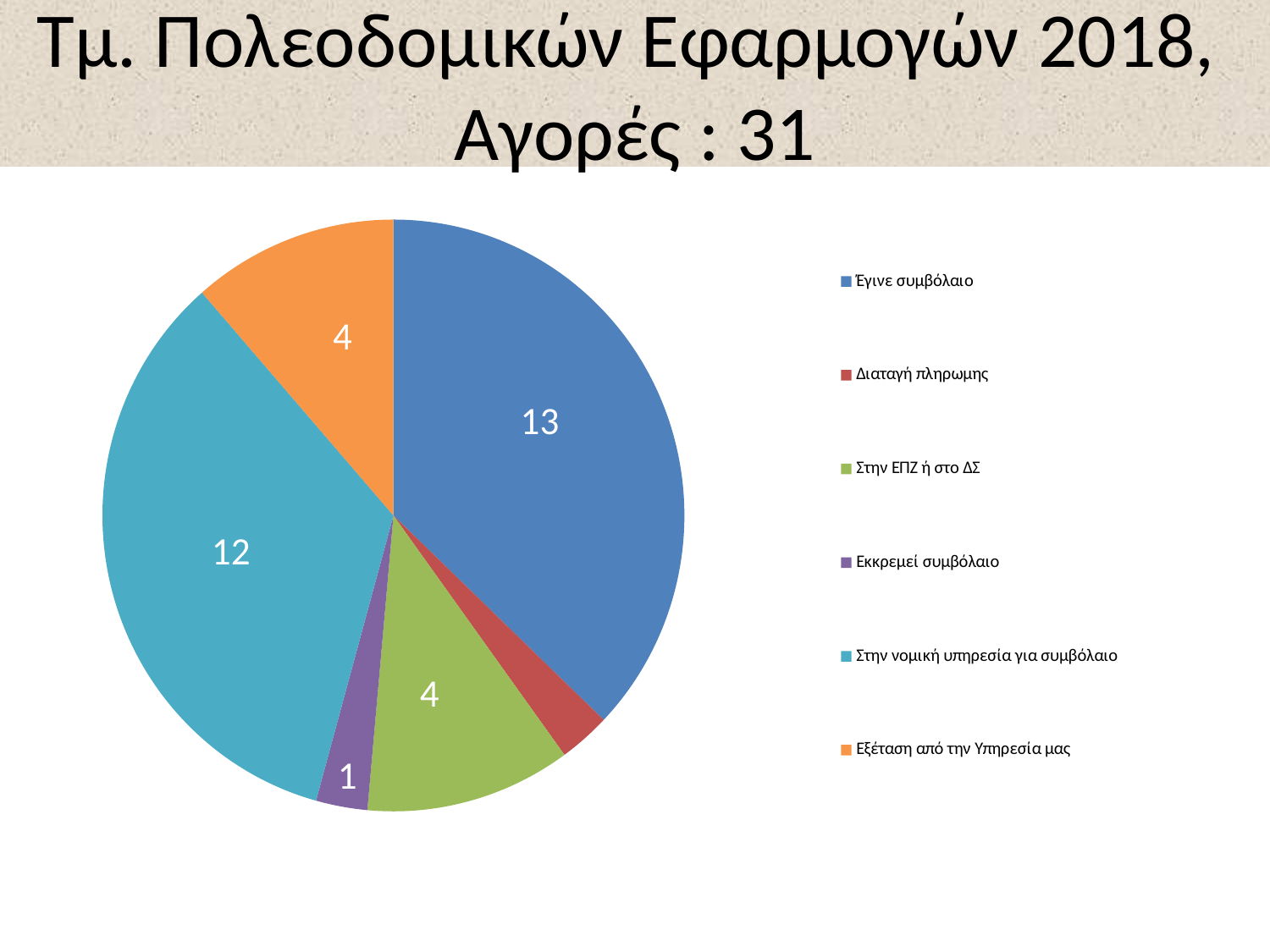
What is the value for Εξέταση από την Υπηρεσία μας? 4 Which category has the largest slice of the pie? Έγινε συμβόλαιο What is the value for Έγινε συμβόλαιο? 13 How many categories does the legend list? 6 What is the value for Στην ΕΠΖ ή στο ΔΣ? 4 What type of chart is shown on the slide? Pie chart What is the value for Στην νομική υπηρεσία για συμβόλαιο? 12 What is the difference between the values for Στην νομική υπηρεσία για συμβόλαιο and Εξέταση από την Υπηρεσία μας? 8 Which is larger, Έγινε συμβόλαιο or Στην νομική υπηρεσία για συμβόλαιο? Έγινε συμβόλαιο What is the value for Εκκρεμεί συμβόλαιο? 1 What colour is the slice for Στην νομική υπηρεσία για συμβόλαιο? Teal (light blue) What is the difference between the values for Έγινε συμβόλαιο and Στην νομική υπηρεσία για συμβόλαιο? 1